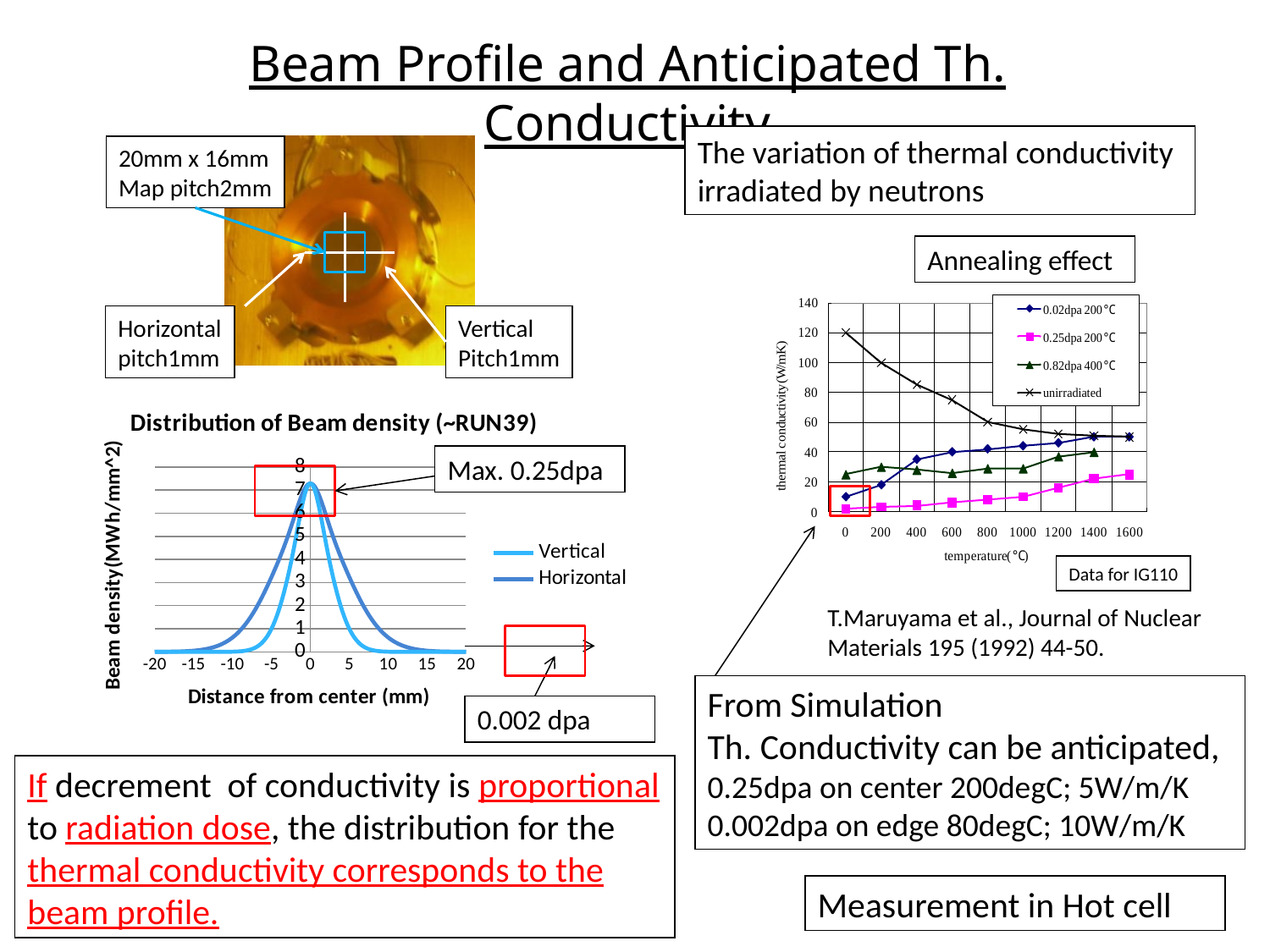
In the 'Distribution of Beam density (~RUN39)' chart, which series is wider, Vertical or Horizontal? Horizontal How many series does the legend of the thermal conductivity versus temperature chart list? 4 In the thermal conductivity versus temperature chart, is the value of the 0.25dpa 200℃ series at 1600 °C greater or less than 40? less What kind of chart is the 'Distribution of Beam density (~RUN39)' chart? line chart In the thermal conductivity versus temperature chart, does the unirradiated series rise or fall as temperature increases? fall In the thermal conductivity versus temperature chart, what is the thermal conductivity of the unirradiated series at 200 °C? 100 In the thermal conductivity versus temperature chart, which series has the highest thermal conductivity at 0 °C? unirradiated What is the y-axis label of the 'Distribution of Beam density (~RUN39)' chart? Beam density(MWh/mm^2) In the thermal conductivity versus temperature chart, which series has the lowest thermal conductivity at 0 °C? 0.25dpa 200℃ In the 'Distribution of Beam density (~RUN39)' chart, is the peak beam density at 0 mm greater or less than 5? greater How many series does the legend of the 'Distribution of Beam density (~RUN39)' chart list? 2 In the thermal conductivity versus temperature chart, what is the thermal conductivity of the unirradiated series at 0 °C? 120